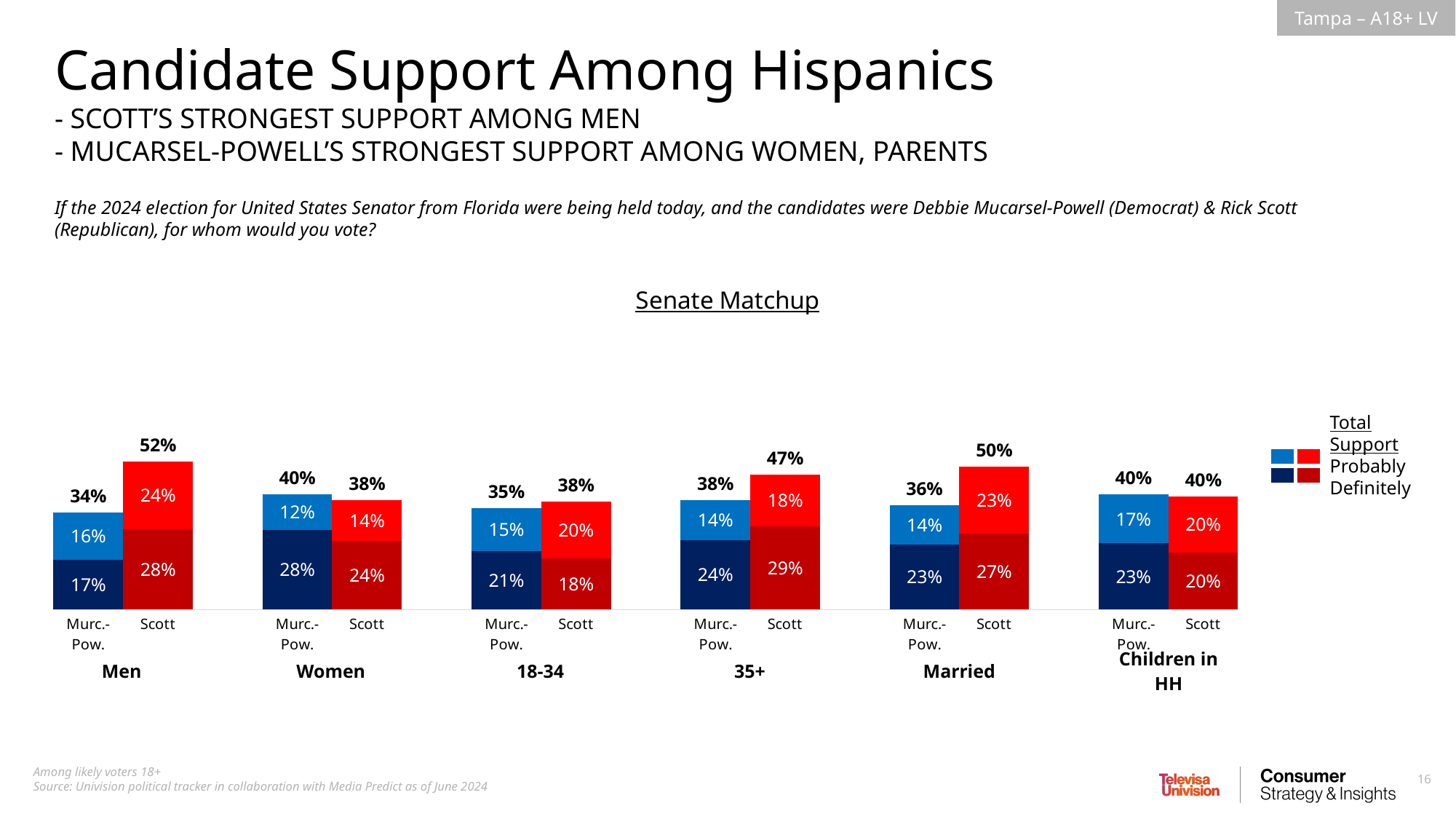
What is the title of the chart? Senate Matchup What is the total support for Scott among Men? 52% In which demographic group does Murc.-Pow. have her lowest total support? Men What kind of chart is shown on the slide? Stacked bar chart In which demographic group does Scott have his highest total support? Men How many demographic groups are shown on the x axis of the chart? 6 What is the 'Definitely' share for Murc.-Pow. among Women? 28% What is the difference between Scott's and Murc.-Pow.'s total support among Men? 18% Which two support levels does the legend distinguish? Probably and Definitely What is the 'Probably' share for Scott among 35+? 18% Among Women, who has higher total support, Murc.-Pow. or Scott? Murc.-Pow.